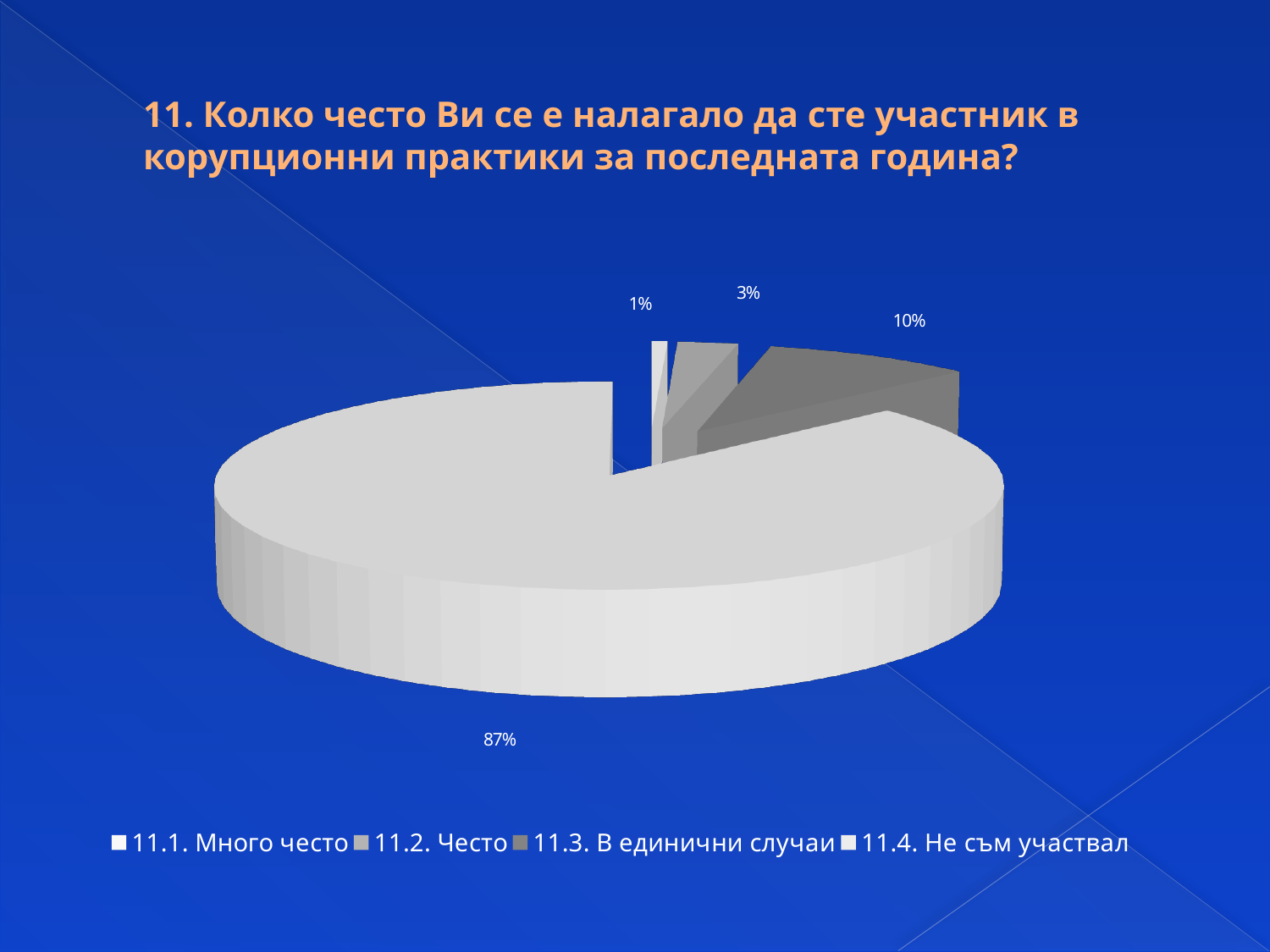
What share of the pie does "11.2. Често" have? 3% Which category has the smallest slice of the pie? 11.1. Много често What is the difference between the shares of "11.3. В единични случаи" and "11.2. Често"? 7% What kind of chart is shown on the slide? pie chart What is the title of the chart on the slide? 11. Колко често Ви се е налагало да сте участник в корупционни практики за последната година? What share of the pie does "11.4. Не съм участвал" have? 87% How many entries does the legend list? 4 What share of the pie does "11.3. В единични случаи" have? 10% How many slices does the pie chart have? 4 Which is larger, the share for "11.2. Често" or the share for "11.3. В единични случаи"? 11.3. В единични случаи Which category has the largest slice of the pie? 11.4. Не съм участвал